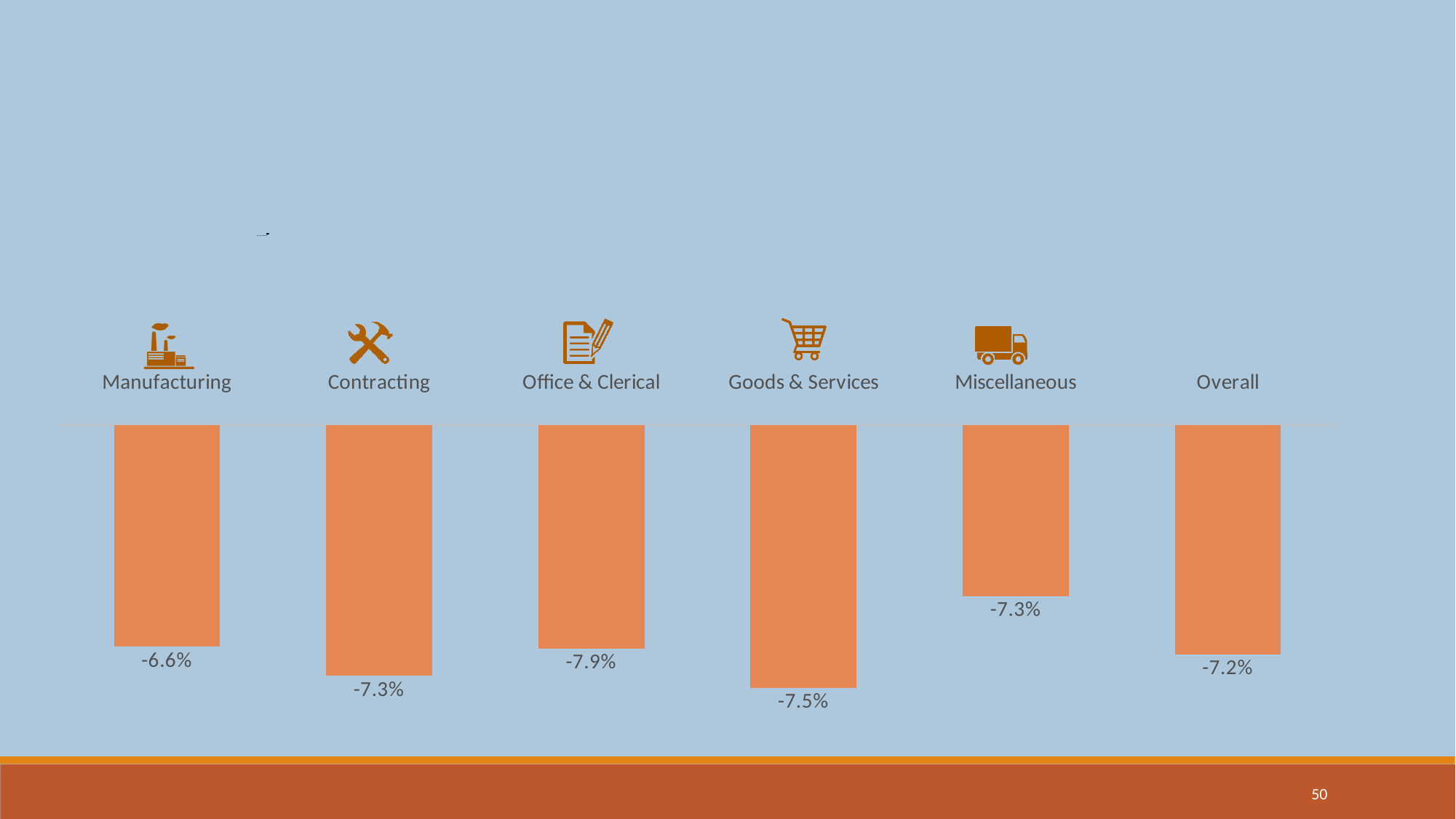
What colour are the bars in the chart? Orange What is the value shown for Manufacturing? -6.6% How many categories are plotted in the chart? 6 What is the value shown for Overall? -7.2% What is the value shown for Office & Clerical? -7.9% What kind of chart is shown on the slide? Bar chart Which has a larger decline, Goods & Services or Overall? Goods & Services What is the value shown for Contracting? -7.3% What is the value shown for Goods & Services? -7.5% What is the difference between the Office & Clerical value and the Manufacturing value? 1.3 percentage points